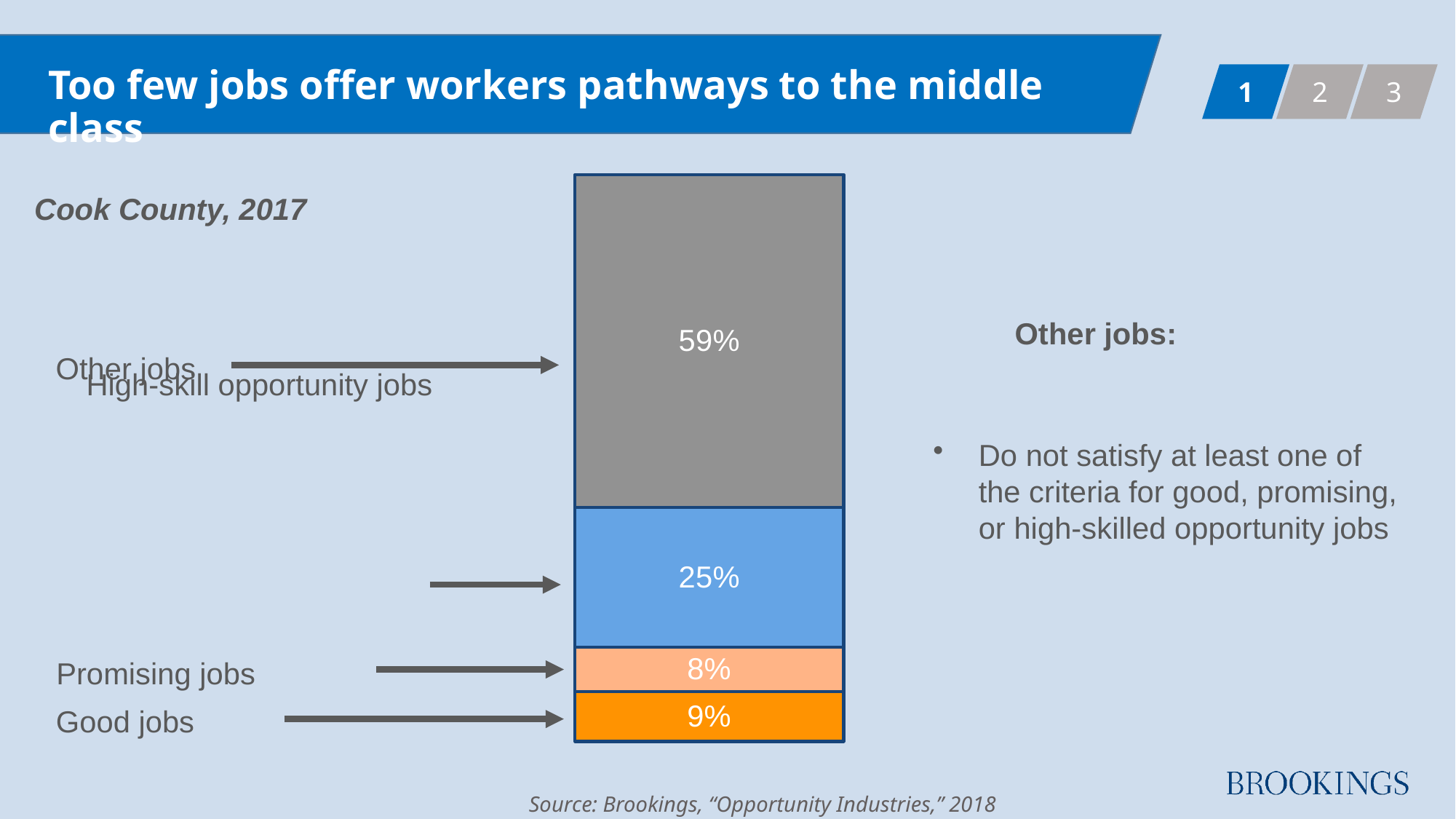
Which category has the smallest share of jobs? Promising jobs What kind of chart is shown on the slide? Stacked bar chart What percentage of jobs in Cook County, 2017 are Good jobs? 9% What colour is the Good jobs segment of the bar? Orange How many percentage points larger is the Other jobs share than the Good jobs share? 50 percentage points Which is larger, the share of Good jobs or the share of Promising jobs? Good jobs What percentage of jobs are Other jobs? 59% How many segments make up the stacked bar? 4 Which category has the largest share of jobs? Other jobs Which county and year does the chart describe? Cook County, 2017 What percentage of jobs are Promising jobs? 8% What value is shown on the blue segment of the bar? 25%